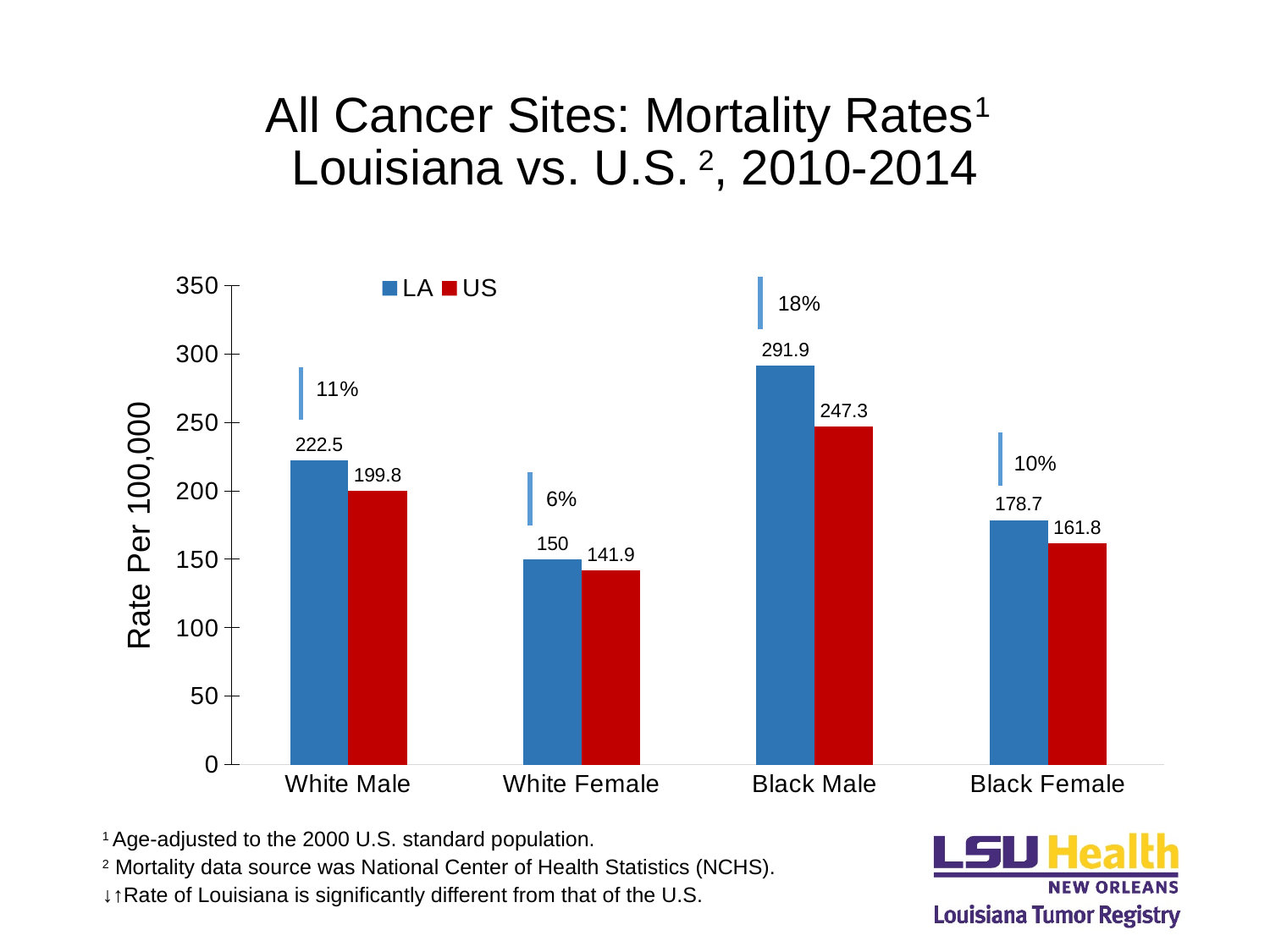
What is the LA mortality rate for Black Male? 291.9 How many series does the legend list? 2 What percentage difference is annotated above the Black Male bars? 18% Which is larger, the LA rate for White Male or the LA rate for Black Female? LA rate for White Male Which category has the lowest US mortality rate? White Female What is the difference between the LA and US mortality rates for Black Male? 44.6 Which category has the highest LA mortality rate? Black Male What kind of chart is shown on the slide? Bar chart What is the difference between the LA and US mortality rates for White Male? 22.7 How many categories are shown on the x axis? 4 What is the LA mortality rate for Black Female? 178.7 What is the US mortality rate for White Female? 141.9